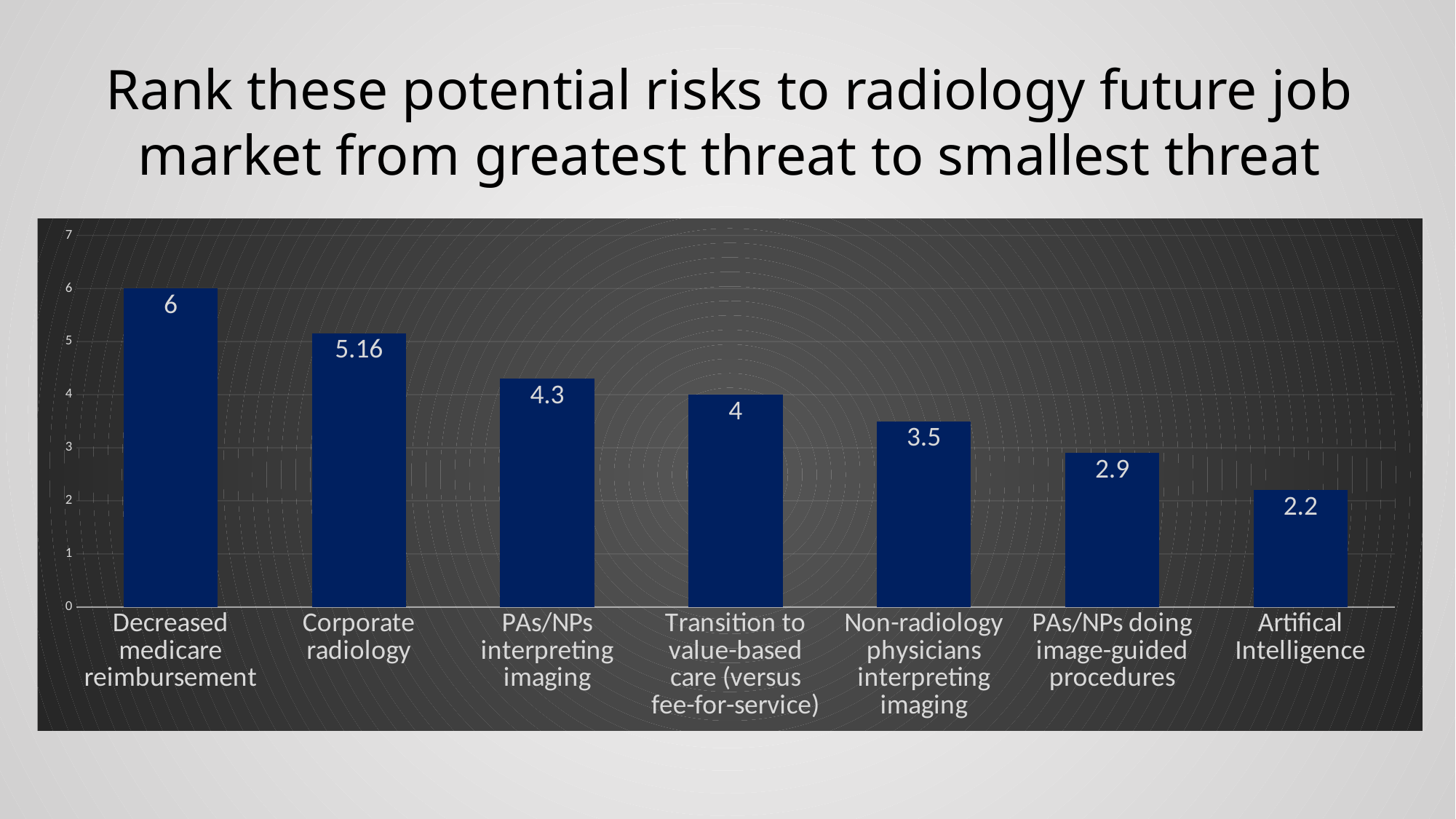
What is the value for Non-radiology physicians interpreting imaging? 3.5 How many categories are shown in the chart? 7 What is the difference between the values for PAs/NPs interpreting imaging and PAs/NPs doing image-guided procedures? 1.4 Which is larger, the value for Transition to value-based care (versus fee-for-service) or the value for Non-radiology physicians interpreting imaging? Transition to value-based care (versus fee-for-service) What kind of chart is shown on the slide? Bar chart Which category has the highest value? Decreased medicare reimbursement What is the value for Decreased medicare reimbursement? 6 Is the value for PAs/NPs doing image-guided procedures greater or less than 3? less Which category has the lowest value? Artifical Intelligence Do the values rise or fall from left to right along the x axis? Fall What is the value for Artifical Intelligence? 2.2 What is the value for Corporate radiology? 5.16